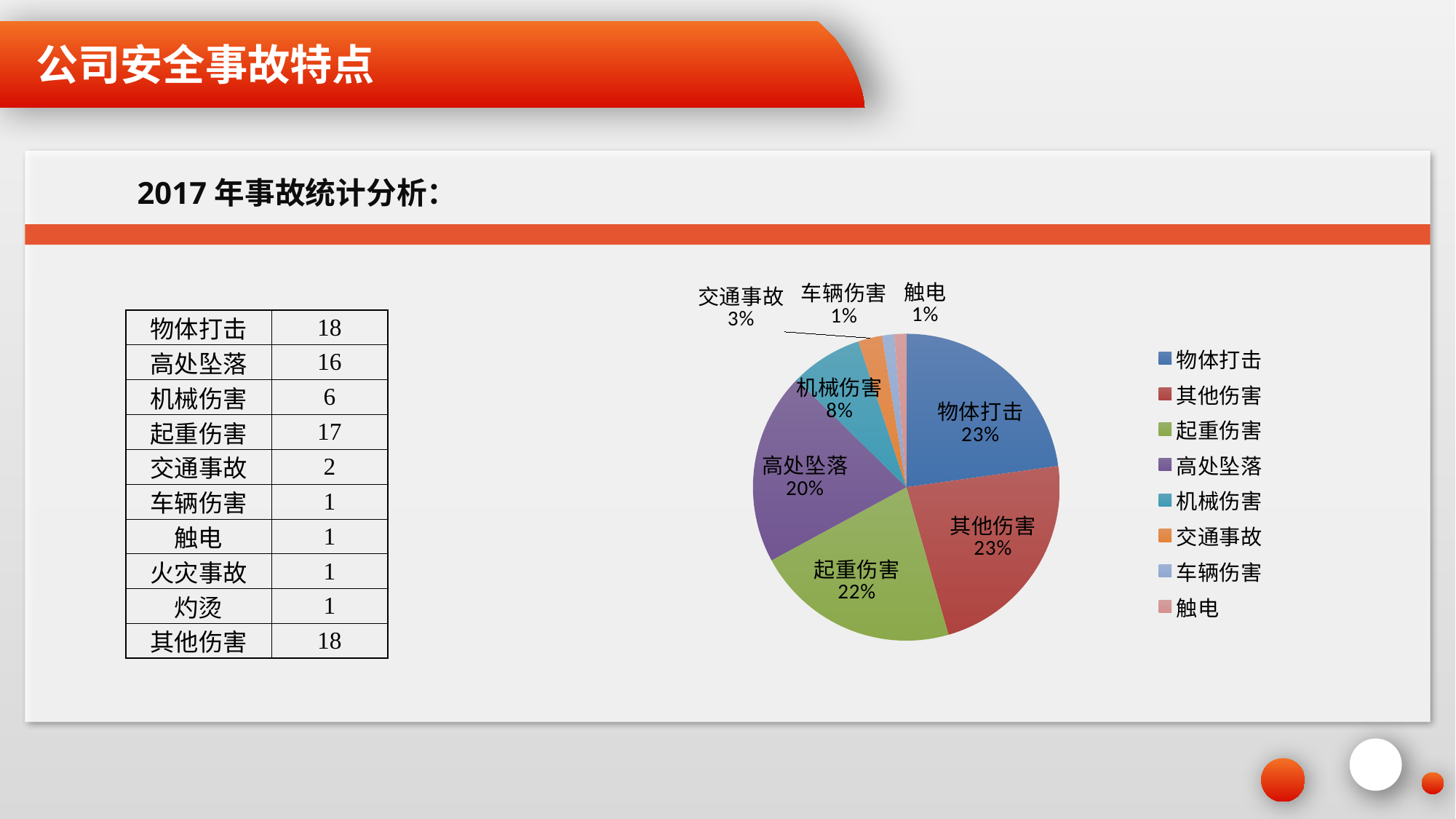
What percentage share does 触电 have in the pie chart? 1% What percentage share does 机械伤害 have in the pie chart? 8% What kind of chart is shown on the slide? pie chart Which colour represents 其他伤害 in the pie chart? red Which has the larger share in the pie chart, 起重伤害 or 高处坠落? 起重伤害 What percentage share does 交通事故 have in the pie chart? 3% What percentage share does 物体打击 have in the pie chart? 23% What percentage share does 高处坠落 have in the pie chart? 20% What is the difference in percentage points between the shares of 高处坠落 and 机械伤害 in the pie chart? 12 How many entries does the legend of the pie chart list? 8 How many slices does the pie chart have? 8 What percentage share does 起重伤害 have in the pie chart? 22%